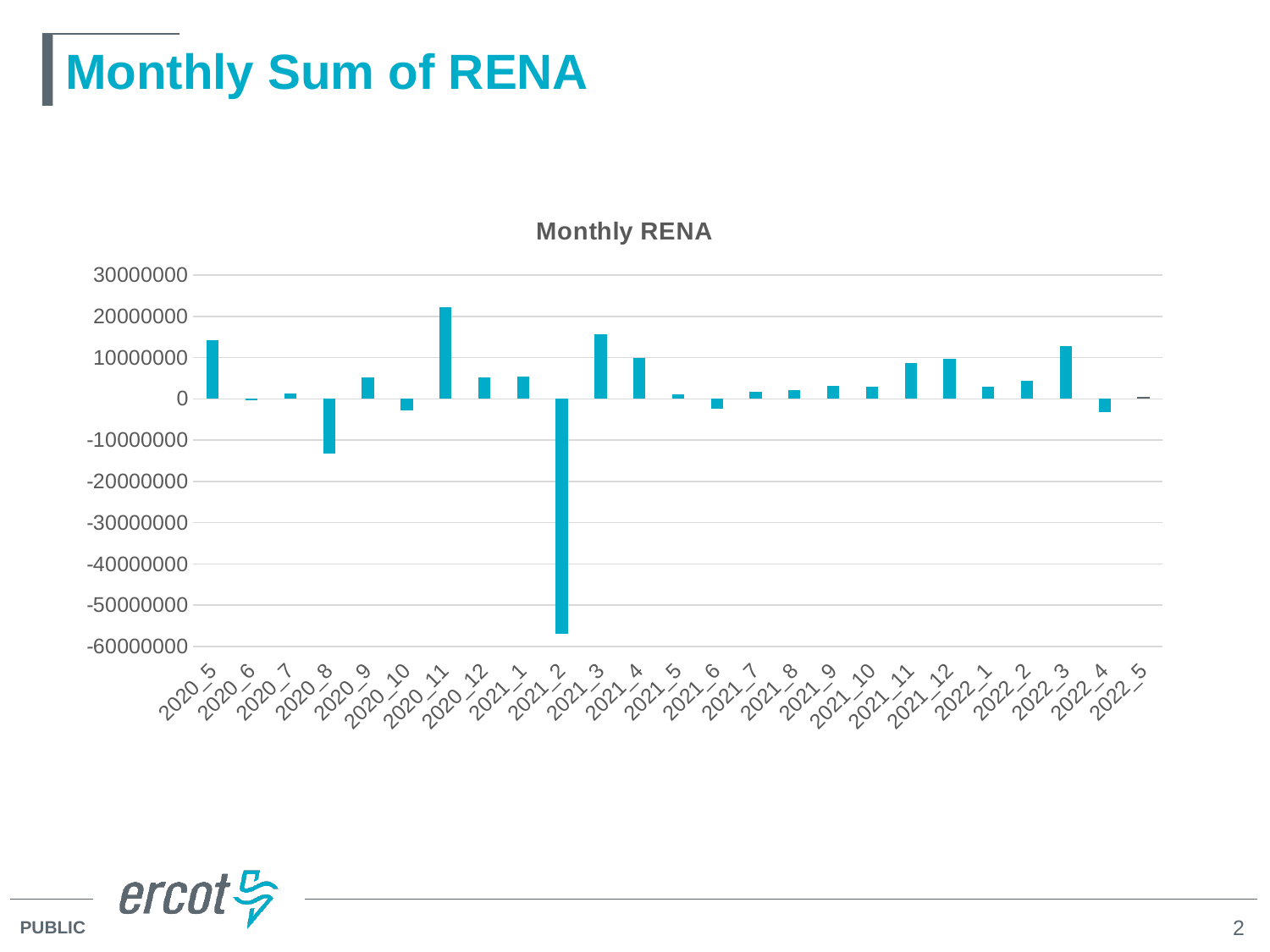
Which month has the lowest Monthly RENA value? 2021_2 Is the value for 2020_5 greater or less than 10000000? greater Is the value for 2021_2 greater or less than -50000000? less What is the title of the chart? Monthly RENA What is the first month shown on the x axis? 2020_5 Which is larger, the value for 2020_11 or the value for 2021_3? 2020_11 What kind of chart is shown on the slide? bar chart Which is larger, the value for 2021_4 or the value for 2021_5? 2021_4 Is the value for 2020_8 greater or less than -10000000? less Which month has the highest Monthly RENA value? 2020_11 How many months (categories) are plotted on the x axis? 25